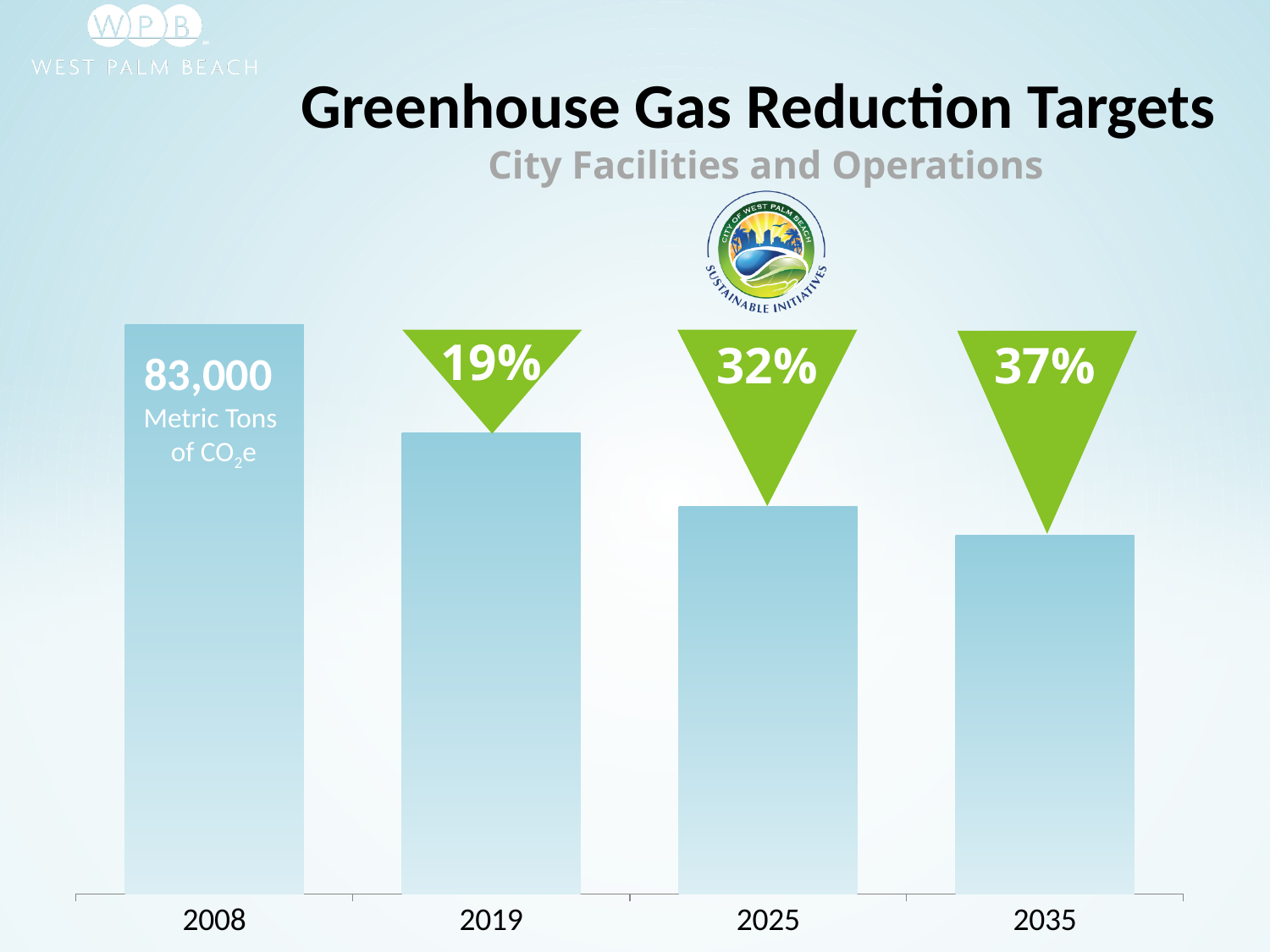
How many bars (years) are shown in the chart? 4 What is the title of the chart? Greenhouse Gas Reduction Targets What is the value shown for 2008? 83,000 Metric Tons of CO2e What kind of chart is shown on the slide? bar chart How many percentage points larger is the 2035 reduction target than the 2019 reduction target? 18 Which year has the shortest bar? 2035 What reduction percentage is shown above the 2035 bar? 37% Do the bars rise or fall from 2008 to 2035? fall What reduction percentage is shown above the 2025 bar? 32% What reduction percentage is shown above the 2019 bar? 19% Which year has the tallest bar? 2008 Which bar is taller, 2019 or 2025? 2019